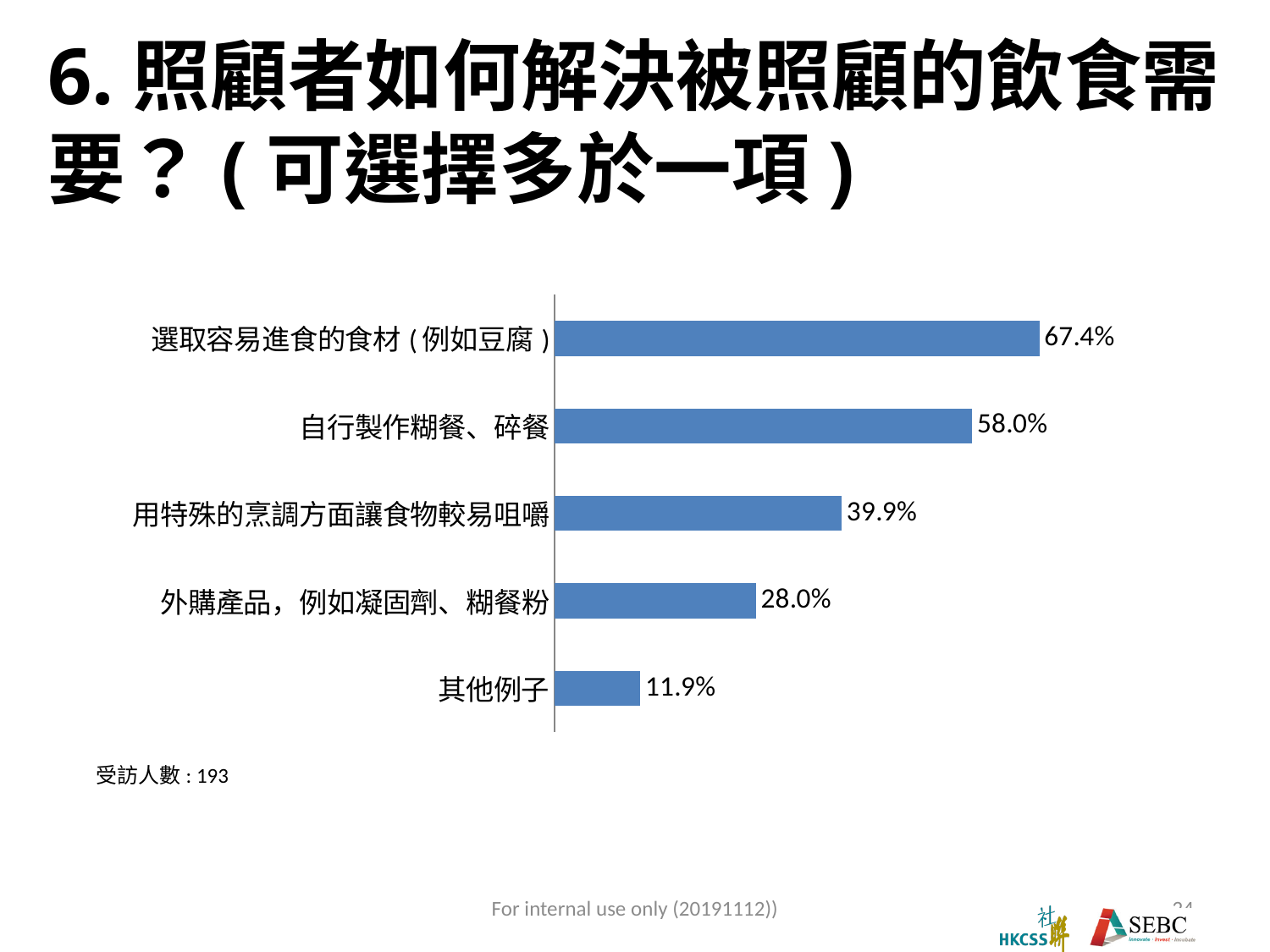
What kind of chart is shown on the slide? Bar chart What is the value for 外購產品，例如凝固劑、糊餐粉? 28.0% What is the value for 選取容易進食的食材 ( 例如豆腐 )? 67.4% Which is larger, the value for 用特殊的烹調方面讓食物較易咀嚼 or the value for 外購產品，例如凝固劑、糊餐粉? 用特殊的烹調方面讓食物較易咀嚼 What is the value for 用特殊的烹調方面讓食物較易咀嚼? 39.9% What is the value for 其他例子? 11.9% Which category has the highest value? 選取容易進食的食材 ( 例如豆腐 ) What is the difference between the values for 選取容易進食的食材 ( 例如豆腐 ) and 自行製作糊餐、碎餐? 9.4% What is the value for 自行製作糊餐、碎餐? 58.0% How many categories are shown in the chart? 5 Which category has the lowest value? 其他例子 How many respondents (受訪人數) are noted below the chart? 193